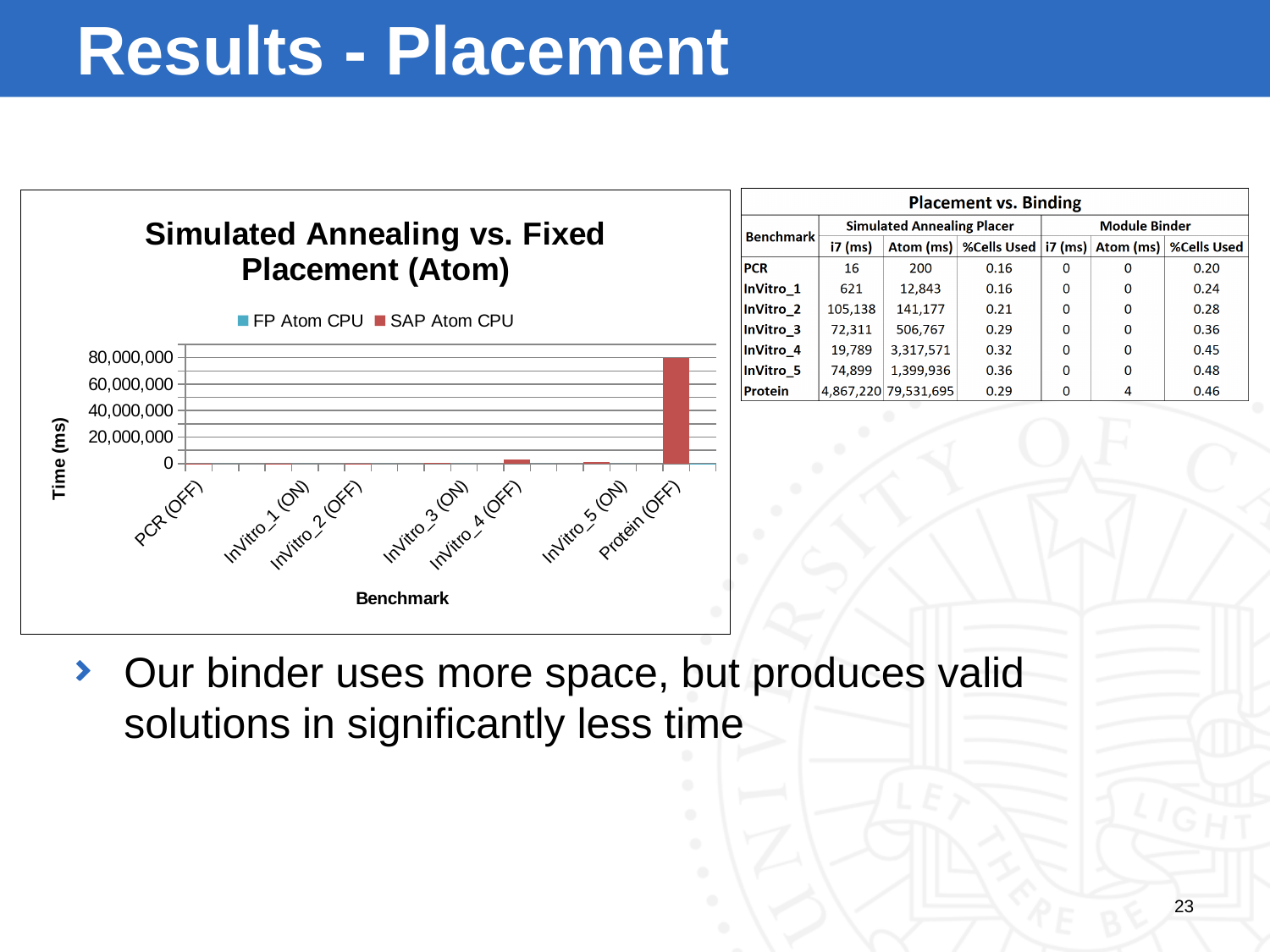
Is the SAP Atom CPU value for InVitro_4 (OFF) greater or less than 20,000,000? less What kind of chart is shown on the slide? bar chart Is the SAP Atom CPU value for Protein (OFF) greater or less than 60,000,000? greater How many series does the legend of the chart list? 2 Which has the larger SAP Atom CPU value, Protein (OFF) or InVitro_4 (OFF)? Protein (OFF) For Protein (OFF), which series has the larger value, FP Atom CPU or SAP Atom CPU? SAP Atom CPU What is the title of the chart? Simulated Annealing vs. Fixed Placement (Atom) Is the SAP Atom CPU value for InVitro_2 (OFF) greater or less than 20,000,000? less What is the label of the vertical axis of the chart? Time (ms) Which benchmark has the highest SAP Atom CPU value in the chart? Protein (OFF)